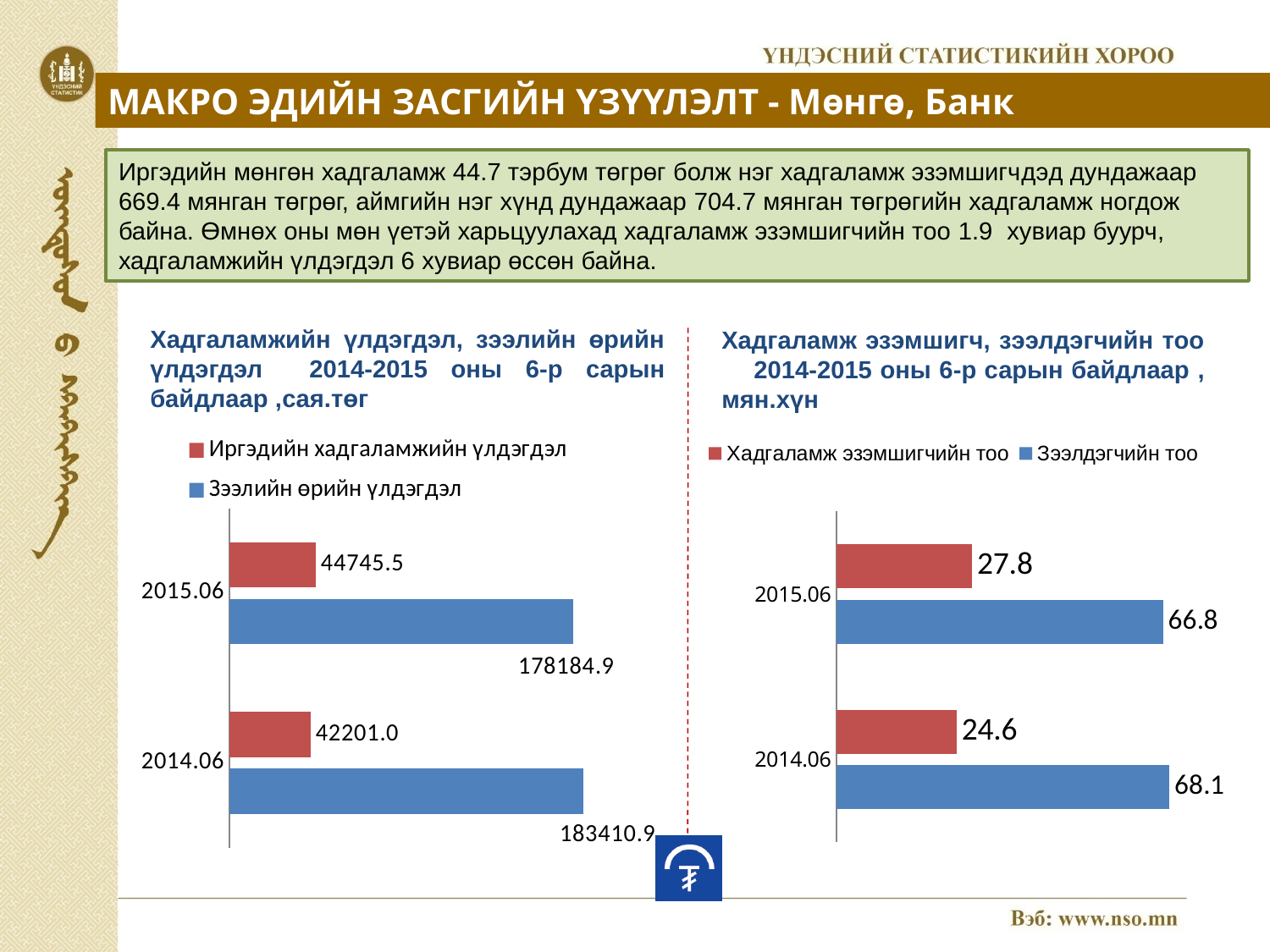
In the left chart, what is the difference between Иргэдийн хадгаламжийн үлдэгдэл in 2015.06 and 2014.06? 2544.5 How many series does the legend of the left chart list? 2 In the right chart, what is the value of Зээлдэгчийн тоо for 2014.06? 68.1 In the right chart, what is the difference between Зээлдэгчийн тоо in 2014.06 and 2015.06? 1.3 In the left chart, what is the value of Иргэдийн хадгаламжийн үлдэгдэл for 2015.06? 44745.5 In the left chart, what is the value of Зээлийн өрийн үлдэгдэл for 2014.06? 183410.9 In the right chart, which period has the higher Хадгаламж эзэмшигчийн тоо? 2015.06 In the left chart, what is the value of Зээлийн өрийн үлдэгдэл for 2015.06? 178184.9 In the right chart, which colour represents Зээлдэгчийн тоо? Blue In the right chart, what is the value of Хадгаламж эзэмшигчийн тоо for 2015.06? 27.8 What kind of chart is the left chart? Bar chart In the left chart, which is larger: Зээлийн өрийн үлдэгдэл in 2014.06 or in 2015.06? 2014.06